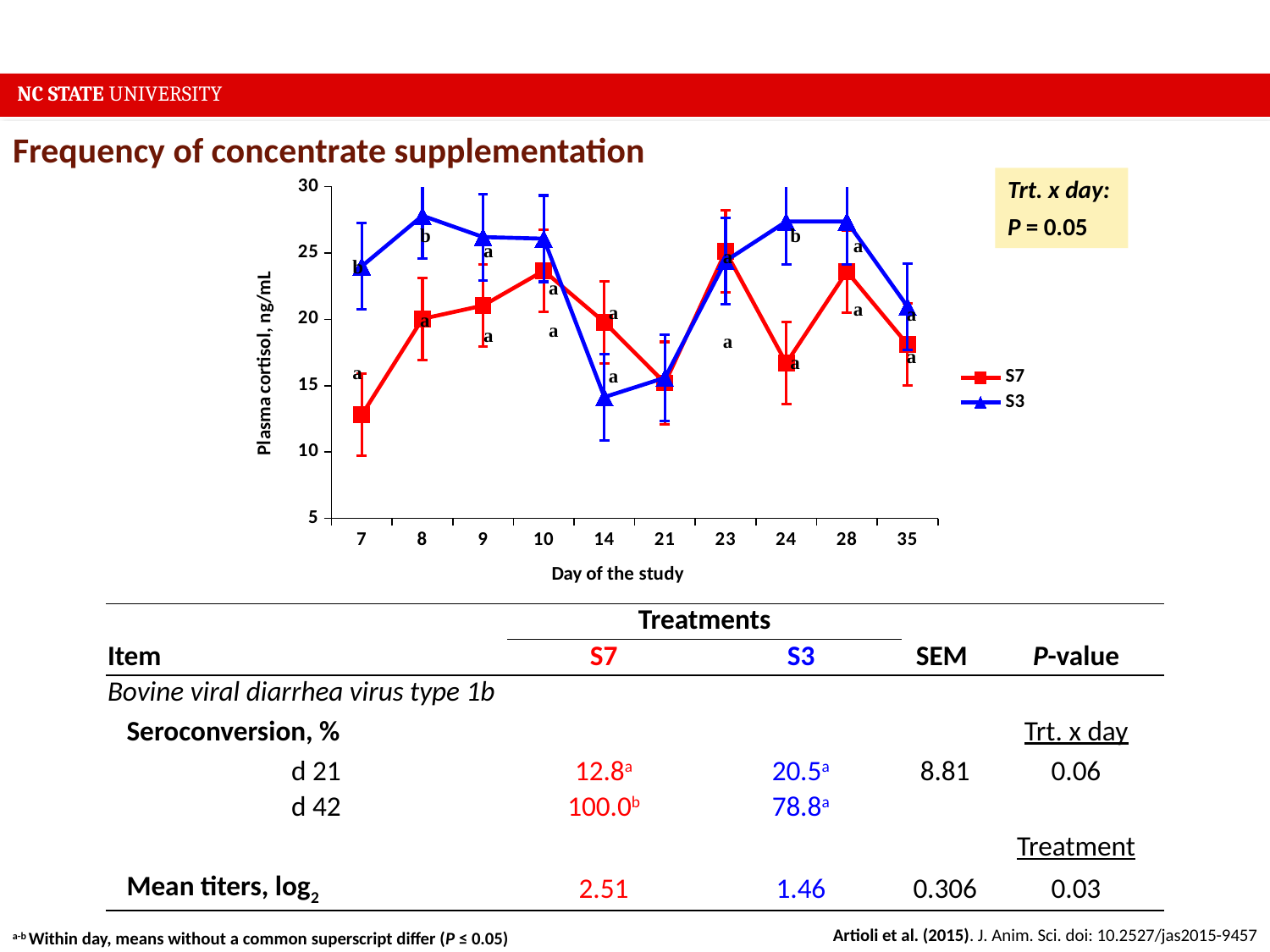
What kind of chart is shown on the slide? Line chart On which day of the study is the S7 plasma cortisol value lowest? 7 Does the S7 plasma cortisol value rise or fall from day 7 to day 10? Rise On day 7, which treatment has the higher plasma cortisol, S7 or S3? S3 Is the plasma cortisol value for S3 on day 8 greater or less than 25? greater Is the plasma cortisol value for S7 on day 7 greater or less than 15? less How many series does the chart legend list? 2 On day 14, which treatment has the higher plasma cortisol, S7 or S3? S7 Is the plasma cortisol value for S3 on day 14 greater or less than 20? less How many days of the study are plotted along the x axis? 10 What is the label of the y axis of the chart? Plasma cortisol, ng/mL